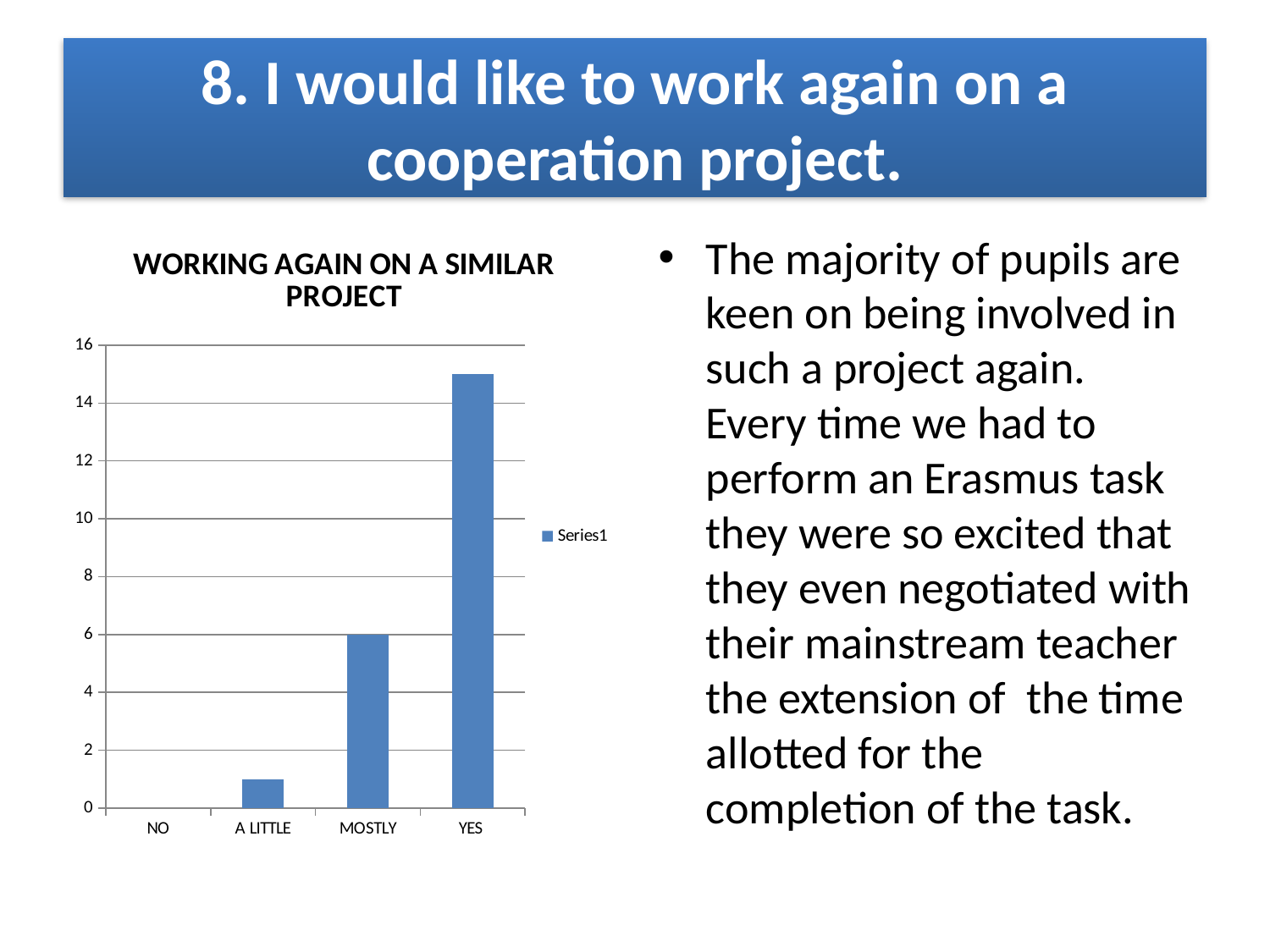
What is the title of the chart? WORKING AGAIN ON A SIMILAR PROJECT Do the values rise or fall moving from NO to YES along the x axis? rise How many series does the chart's legend list? 1 Which category has the highest value in the chart? YES Which has the larger value, MOSTLY or A LITTLE? MOSTLY How many categories are shown on the x axis of the chart? 4 Is the value for A LITTLE greater or less than 2? less What kind of chart is shown on the slide? bar chart Is the value for YES greater or less than 14? greater What is the value for NO in the chart? 0 Which category has the lowest value in the chart? NO What is the value for MOSTLY in the chart? 6